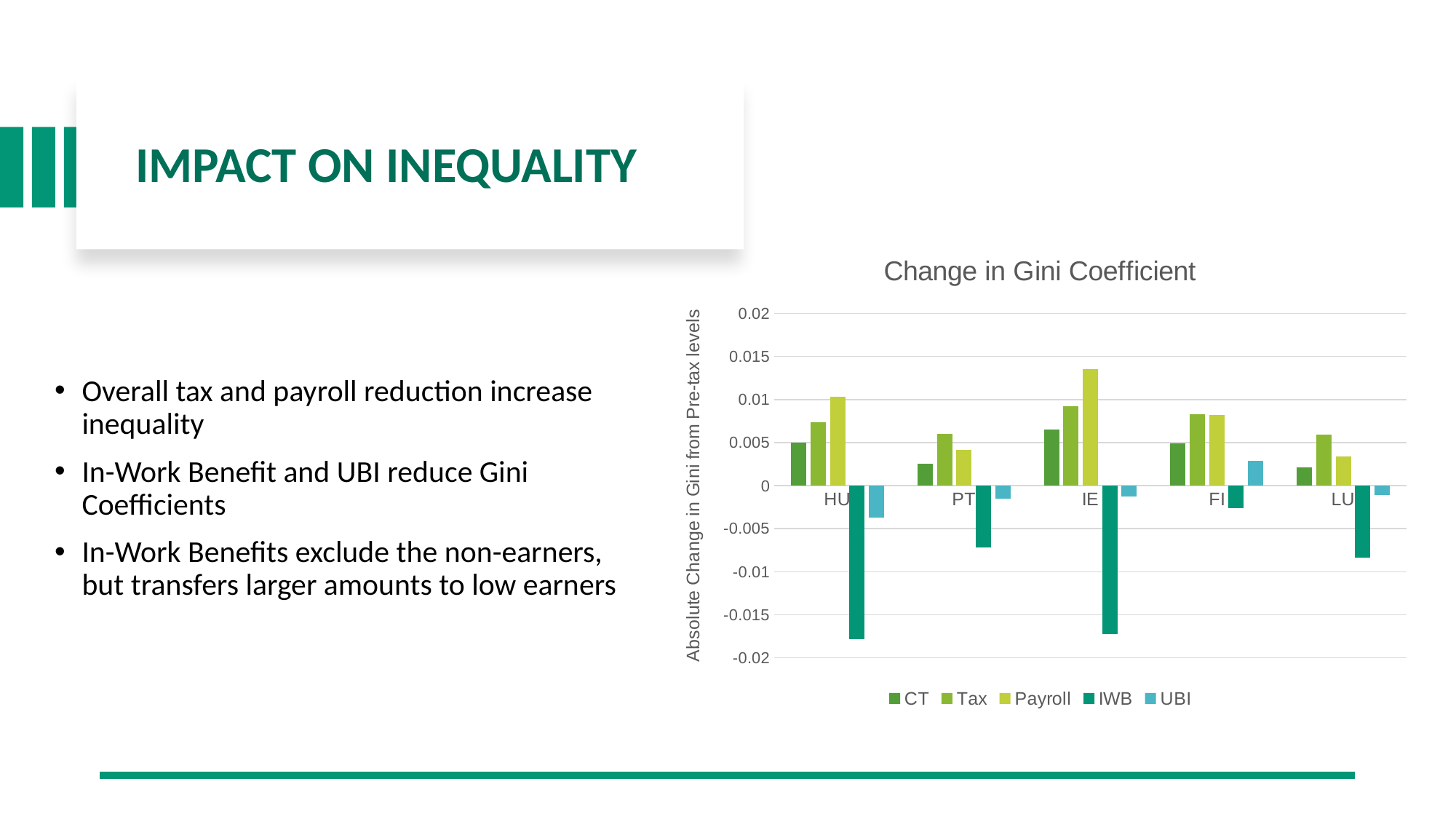
What is the title of the chart? Change in Gini Coefficient Is the UBI value for FI greater or less than 0? greater Which series has the highest value for IE? Payroll Which country has the highest Payroll value? IE How many countries are shown on the x axis of the chart? 5 Is the IWB value for HU greater or less than -0.015? less Which series has the lowest value for HU? IWB Is the Payroll value for IE greater or less than 0.01? greater What is the label of the vertical axis? Absolute Change in Gini from Pre-tax levels What kind of chart is shown on the slide? bar chart Which is larger, the Payroll value for HU or the Payroll value for PT? HU How many series does the chart legend list? 5